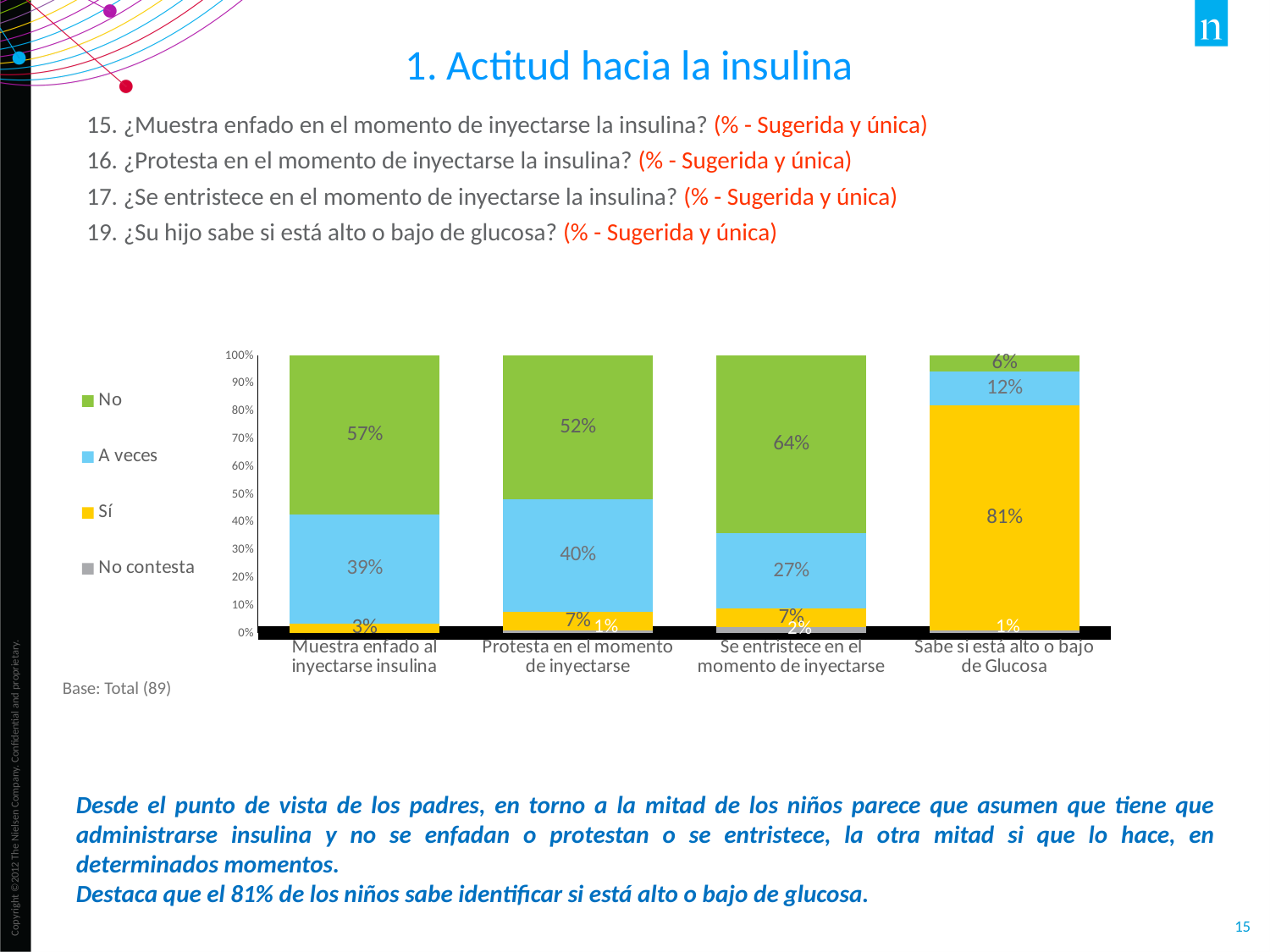
What is the 'Sí' value for 'Sabe si está alto o bajo de Glucosa'? 81% What is the 'A veces' value for 'Protesta en el momento de inyectarse'? 40% Which category has the highest 'No' value? Se entristece en el momento de inyectarse Which is larger: the 'A veces' value for 'Muestra enfado al inyectarse insulina' or the 'A veces' value for 'Se entristece en el momento de inyectarse'? Muestra enfado al inyectarse insulina What is the 'No contesta' value for 'Se entristece en el momento de inyectarse'? 2% Which colour represents the 'Sí' series in the chart? Yellow How many categories are shown on the x axis of the chart? 4 What is the 'No' value for 'Muestra enfado al inyectarse insulina'? 57% What type of chart is shown on the slide? Stacked bar chart How many series does the chart legend list? 4 What is the difference between the 'No' value for 'Se entristece en el momento de inyectarse' and the 'No' value for 'Protesta en el momento de inyectarse'? 12% Which category has the lowest 'Sí' value? Muestra enfado al inyectarse insulina